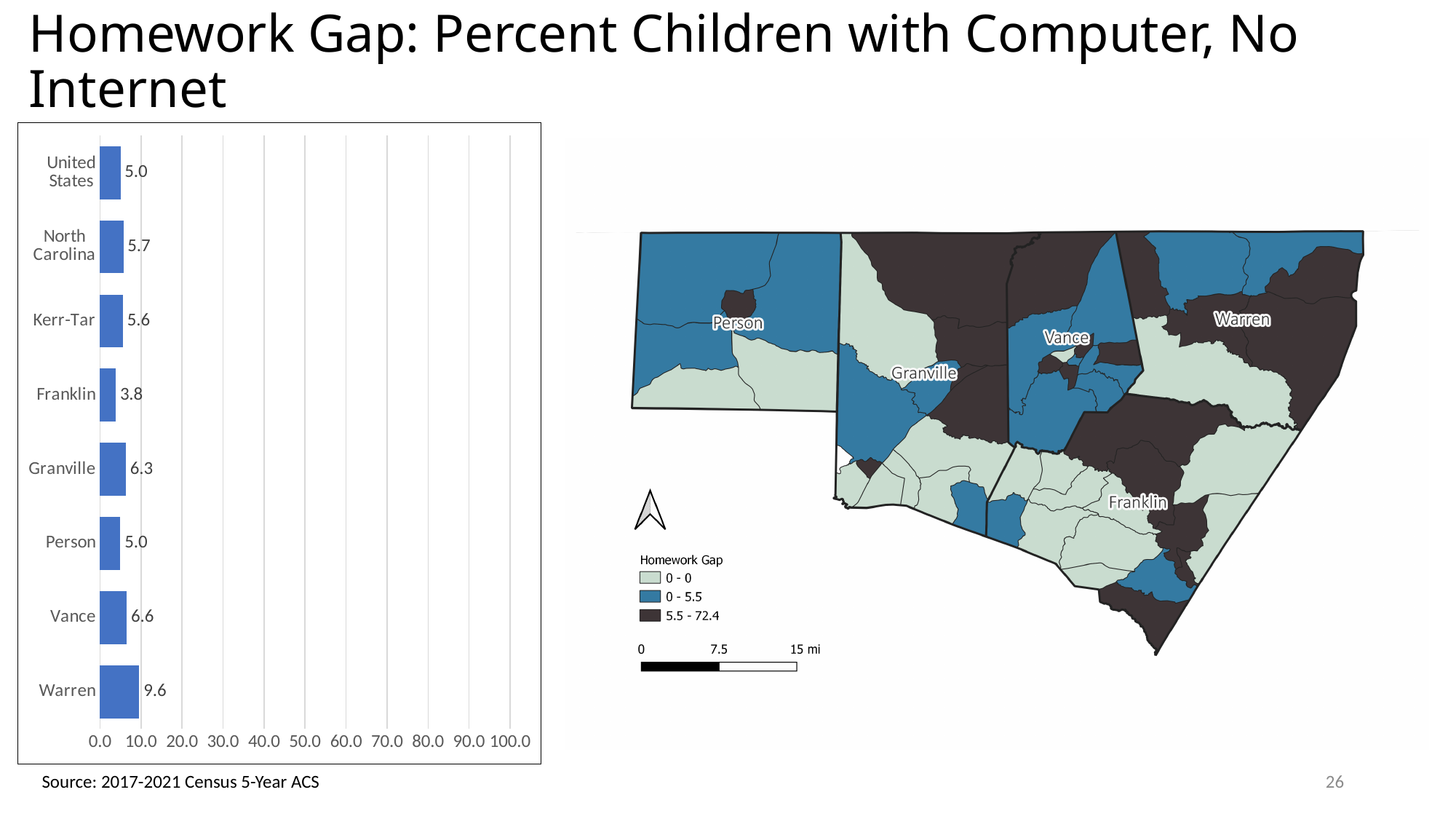
Which category has the lowest value in the bar chart? Franklin What type of chart is shown on the left of the slide? bar chart What is the difference between the values for Warren and Franklin in the bar chart? 5.8 Which has a larger value in the bar chart, Granville or Person? Granville Is the value for Warren in the bar chart greater or less than 10.0? less What is the value for Warren in the bar chart? 9.6 What is the value for Kerr-Tar in the bar chart? 5.6 What is the difference between the values for Vance and Granville in the bar chart? 0.3 What is the value for Franklin in the bar chart? 3.8 What is the value for North Carolina in the bar chart? 5.7 How many categories are shown in the bar chart? 8 Which category has the highest value in the bar chart? Warren